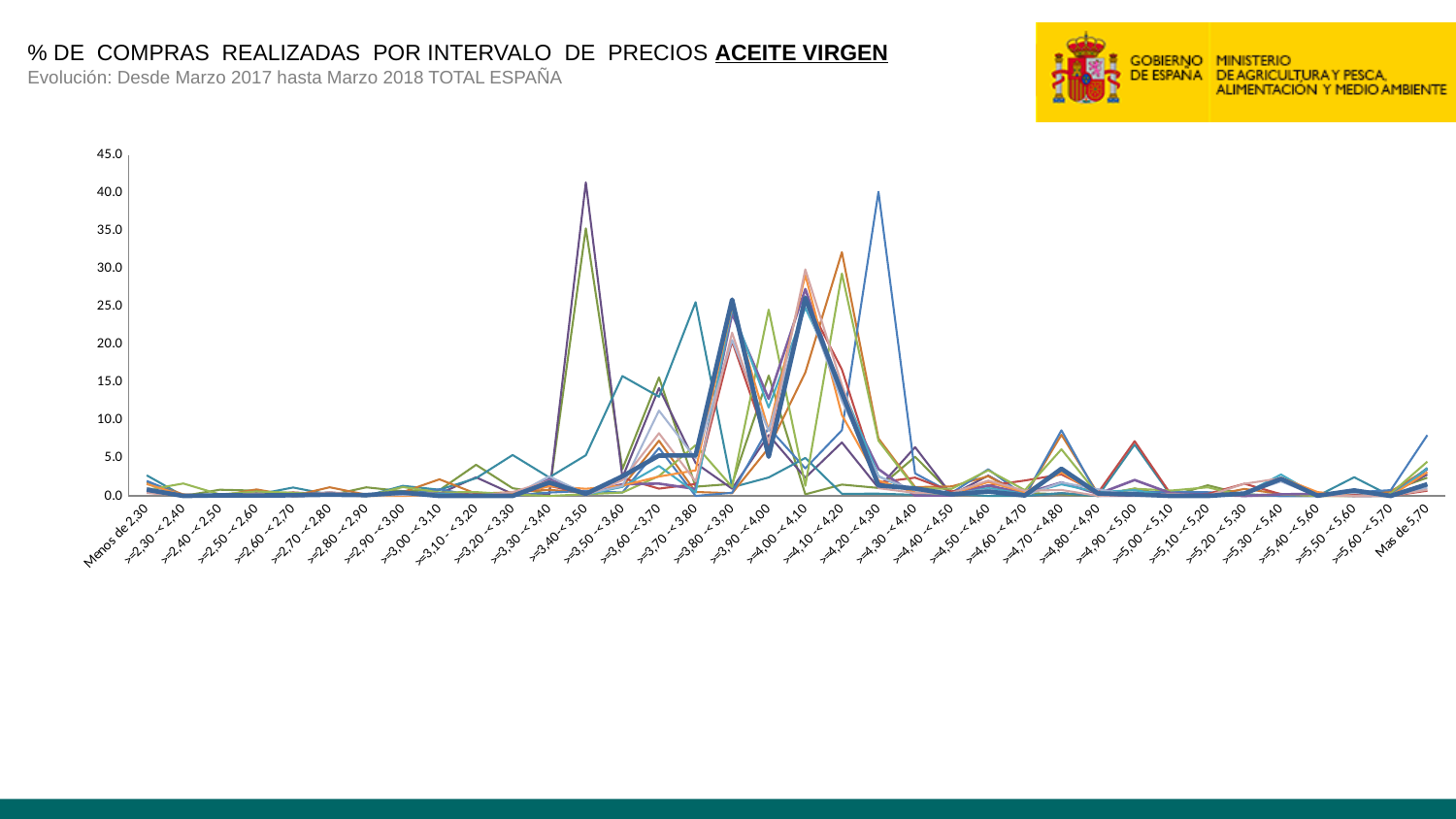
Which product does the chart title say the purchase percentages refer to? ACEITE VIRGEN What is the last category label on the x axis of the chart? Mas de 5,70 What kind of chart is shown on the slide? Line chart How many price intervals (categories) are shown along the x axis of the chart? 36 Is the highest value plotted anywhere on the chart greater or less than 45.0? less Is the highest value plotted anywhere on the chart greater or less than 35.0? greater What period does the chart subtitle say the data covers? Desde Marzo 2017 hasta Marzo 2018 What is the first category label on the x axis of the chart? Menos de 2,30 Are the values plotted for the category 'Menos de 2,30' greater or less than 5.0? less